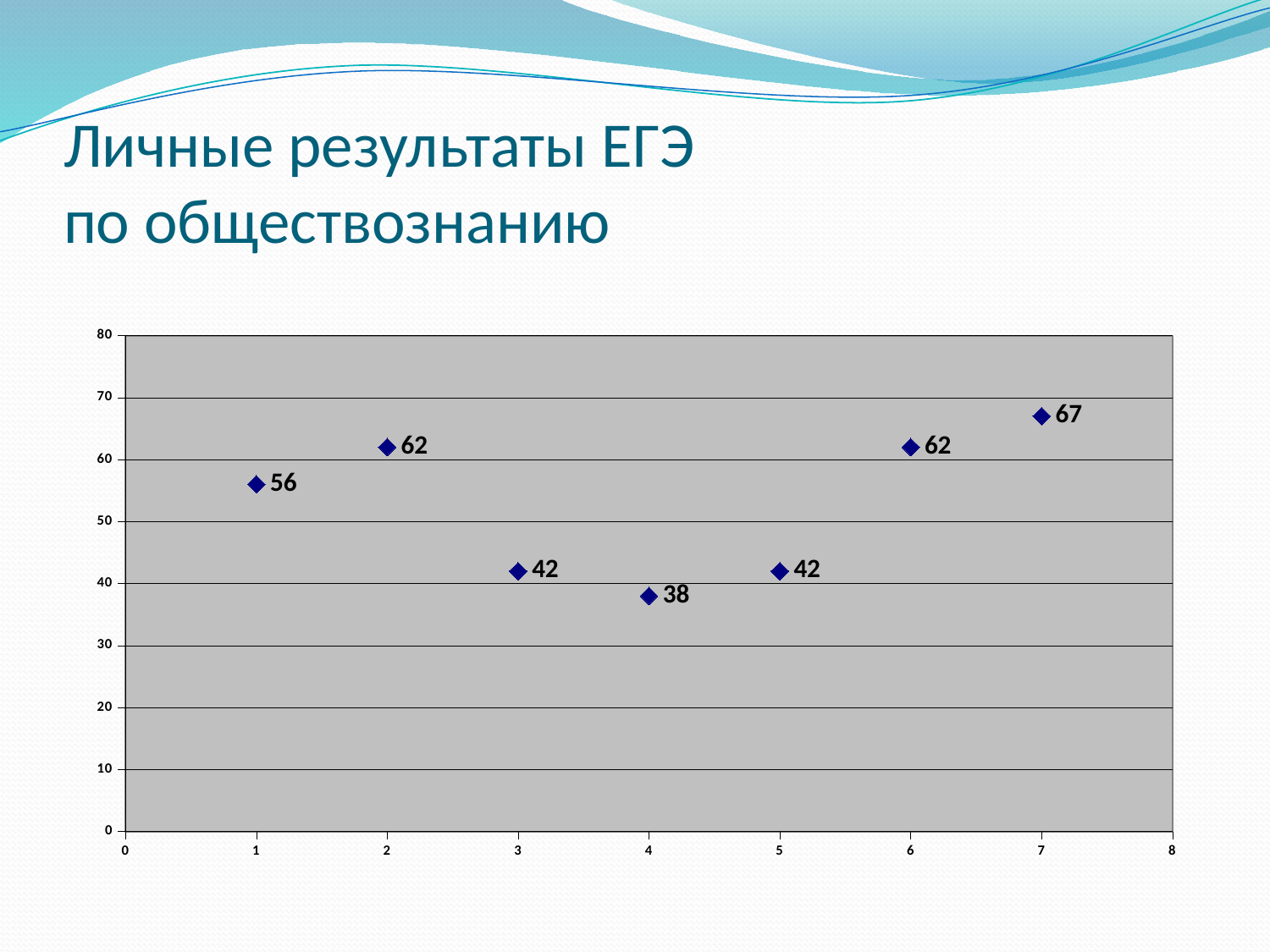
What is the title of the slide containing the chart? Личные результаты ЕГЭ по обществознанию At which x value is the highest point plotted? 7 What value is plotted at x = 7? 67 What kind of chart is shown on the slide? scatter chart What is the difference between the value at x = 2 and the value at x = 1? 6 What value is plotted at x = 4? 38 What value is plotted at x = 1? 56 What is the difference between the value at x = 7 and the value at x = 4? 29 Which is larger, the value at x = 1 or the value at x = 3? x = 1 At which x value is the lowest point plotted? 4 How many data points are plotted on the chart? 7 Is the value at x = 6 greater or less than 50? greater